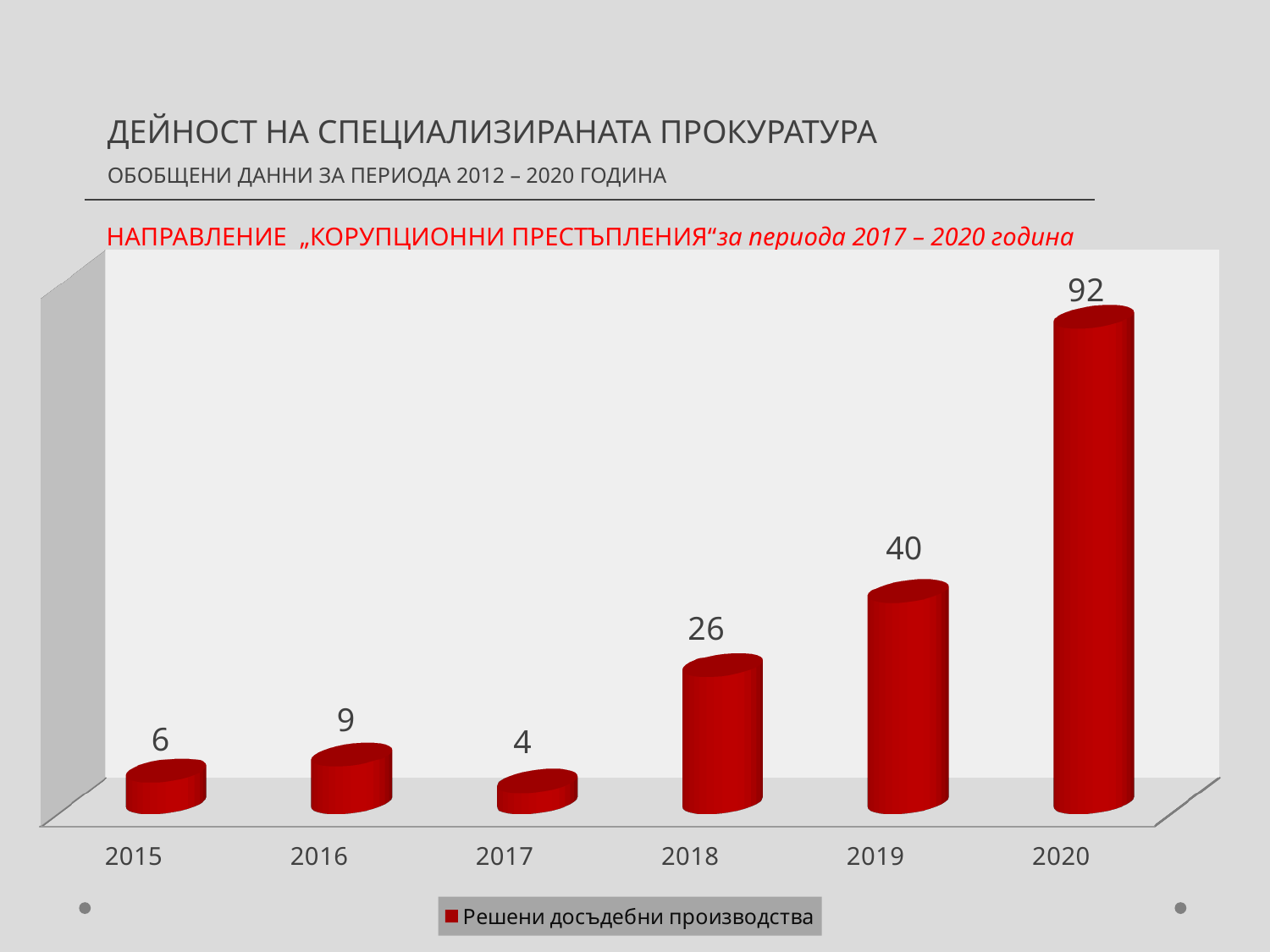
Which year has the lowest value? 2017 What is the difference between the values for 2016 and 2015? 3 What is the legend entry for the series shown? Решени досъдебни производства What is the value for 2017? 4 Which year has the highest value? 2020 What is the value for 2020? 92 How many series does the legend list? 1 What is the difference between the values for 2020 and 2019? 52 What kind of chart is shown on the slide? bar chart How many years are shown on the x axis? 6 Which is larger, the value for 2016 or the value for 2017? 2016 What is the value for 2018? 26